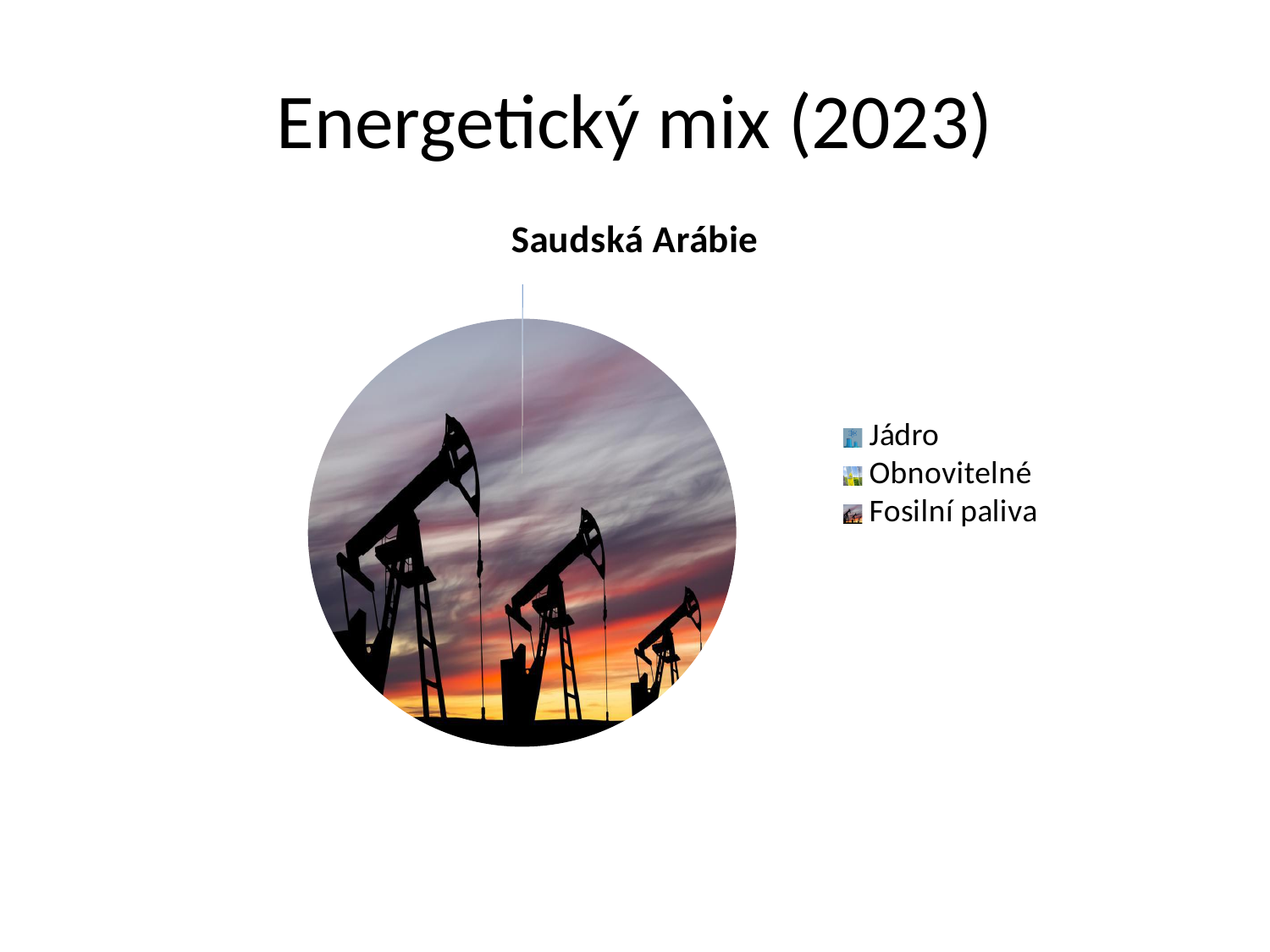
Which is larger in the pie, Fosilní paliva or Obnovitelné? Fosilní paliva Which category takes up the largest share of the pie? Fosilní paliva Which legend entry is listed first? Jádro How many entries does the chart's legend list? 3 What kind of chart is shown on the slide? pie chart What is the title of the chart? Saudská Arábie